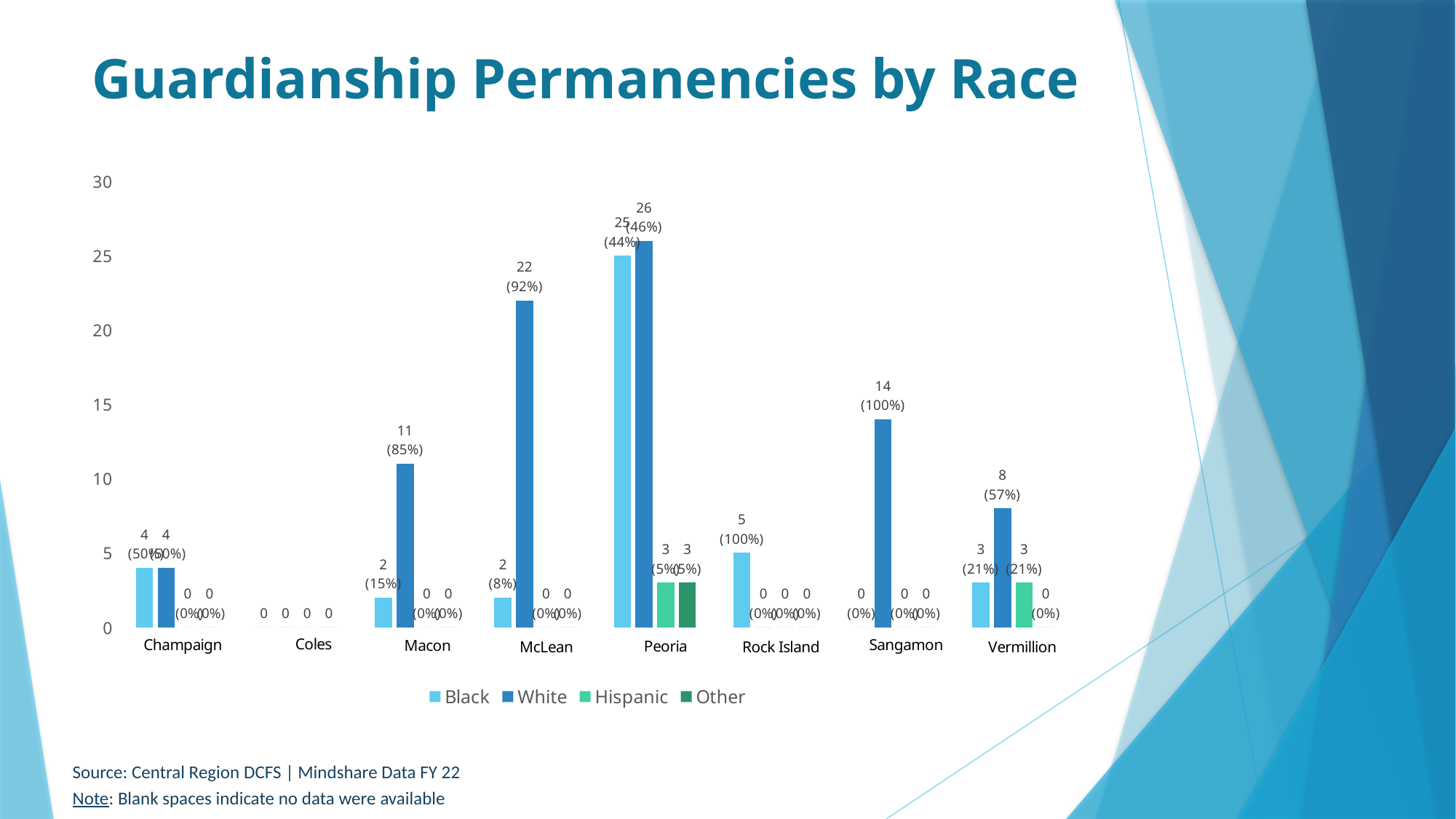
Which is larger in Vermillion, the White value or the Black value? White Which county has the highest White value? Peoria What percentage is shown for White in Macon? 85% How many series does the legend list? 4 What is the value for White in McLean? 22 What is the value for Hispanic in Vermillion? 3 What is the difference between the White and Black values in Macon? 9 What is the value for Black in Peoria? 25 How many counties are shown on the x axis? 8 What is the title of the chart? Guardianship Permanencies by Race Which county has the highest Black value? Peoria What type of chart is shown on the slide? Bar chart